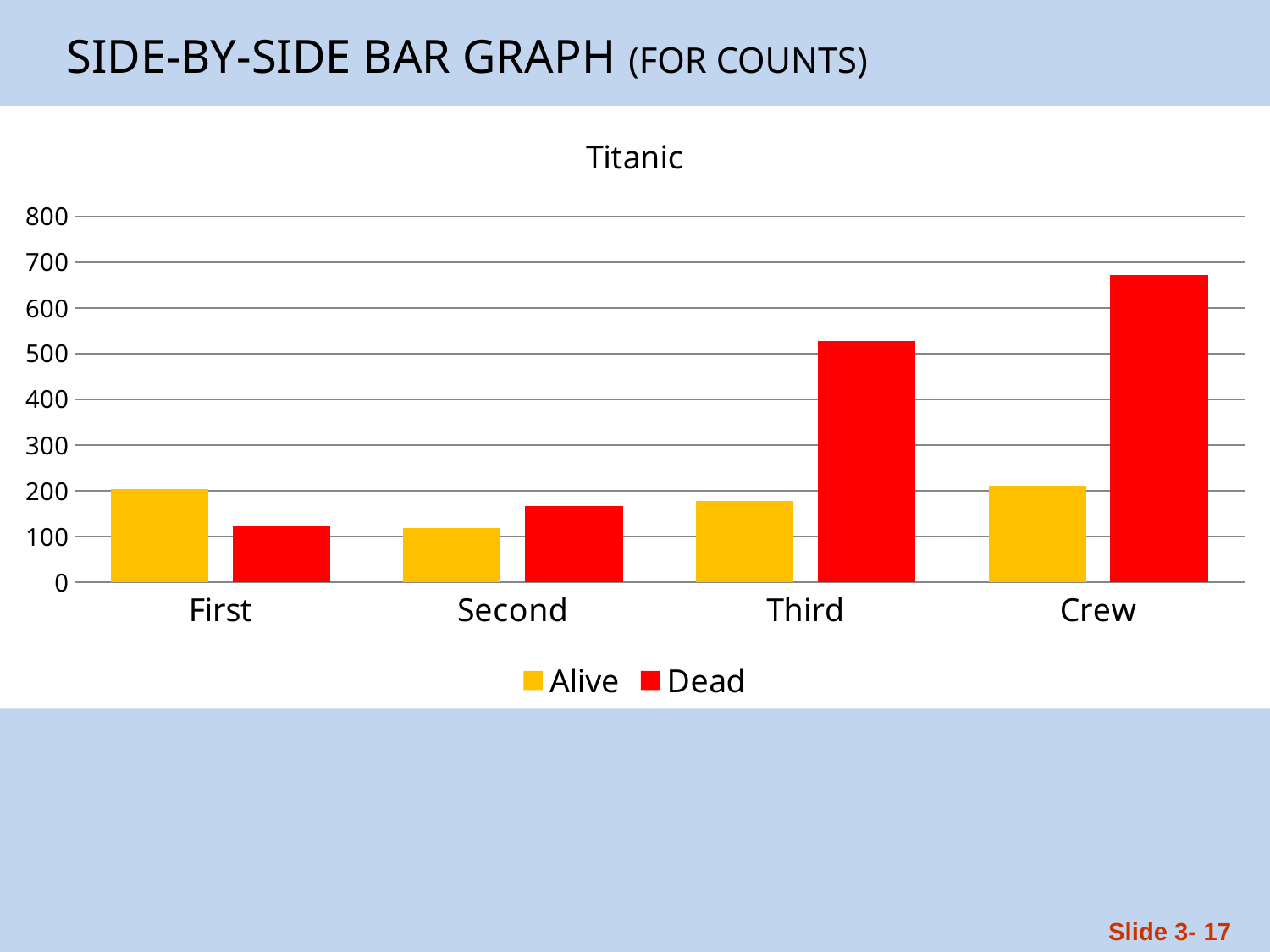
For the First category, which is larger, Alive or Dead? Alive What kind of chart is shown on the slide? bar chart Which category has the highest Dead value? Crew What is the title of the chart? Titanic Is the Dead value for Crew greater or less than 600? greater Is the Dead value for Third greater or less than 400? greater How many series does the legend list? 2 Is the Alive value for Second greater or less than 200? less Which category has the lowest Dead value? First Which colour represents the Dead series in the legend? red How many categories are shown on the x axis? 4 Which category has the lowest Alive value? Second